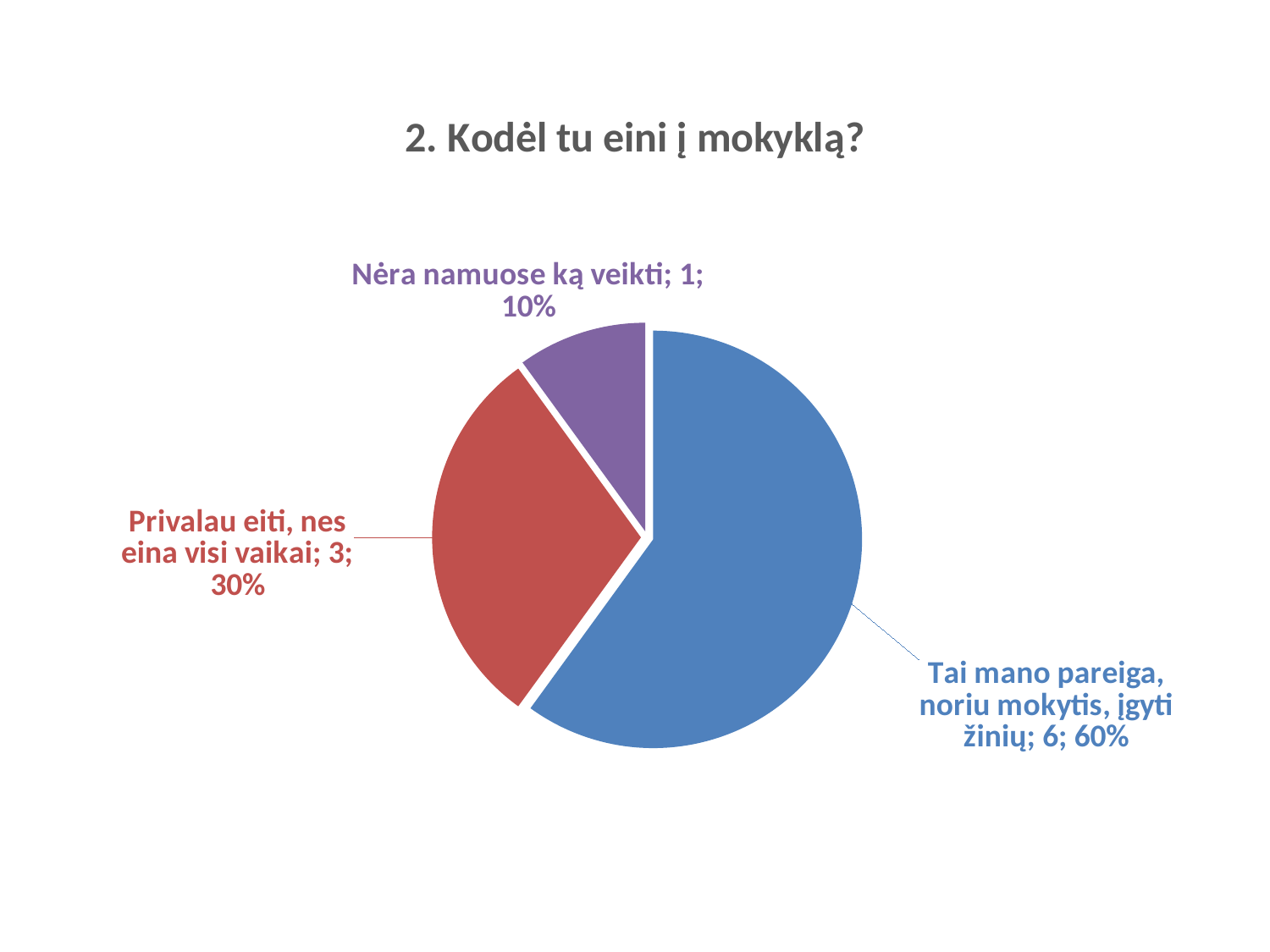
What is the count for "Tai mano pareiga, noriu mokytis, įgyti žinių"? 6 What is the title of the chart? 2. Kodėl tu eini į mokyklą? Which category has the largest slice? Tai mano pareiga, noriu mokytis, įgyti žinių What share of the pie does "Tai mano pareiga, noriu mokytis, įgyti žinių" represent? 60% What share of the pie does "Privalau eiti, nes eina visi vaikai" represent? 30% What kind of chart is shown on the slide? pie chart What is the difference in count between "Tai mano pareiga, noriu mokytis, įgyti žinių" and "Privalau eiti, nes eina visi vaikai"? 3 What is the count for "Privalau eiti, nes eina visi vaikai"? 3 How many slices does the pie chart have? 3 Which category has the smallest slice? Nėra namuose ką veikti What is the count for "Nėra namuose ką veikti"? 1 What share of the pie does "Nėra namuose ką veikti" represent? 10%